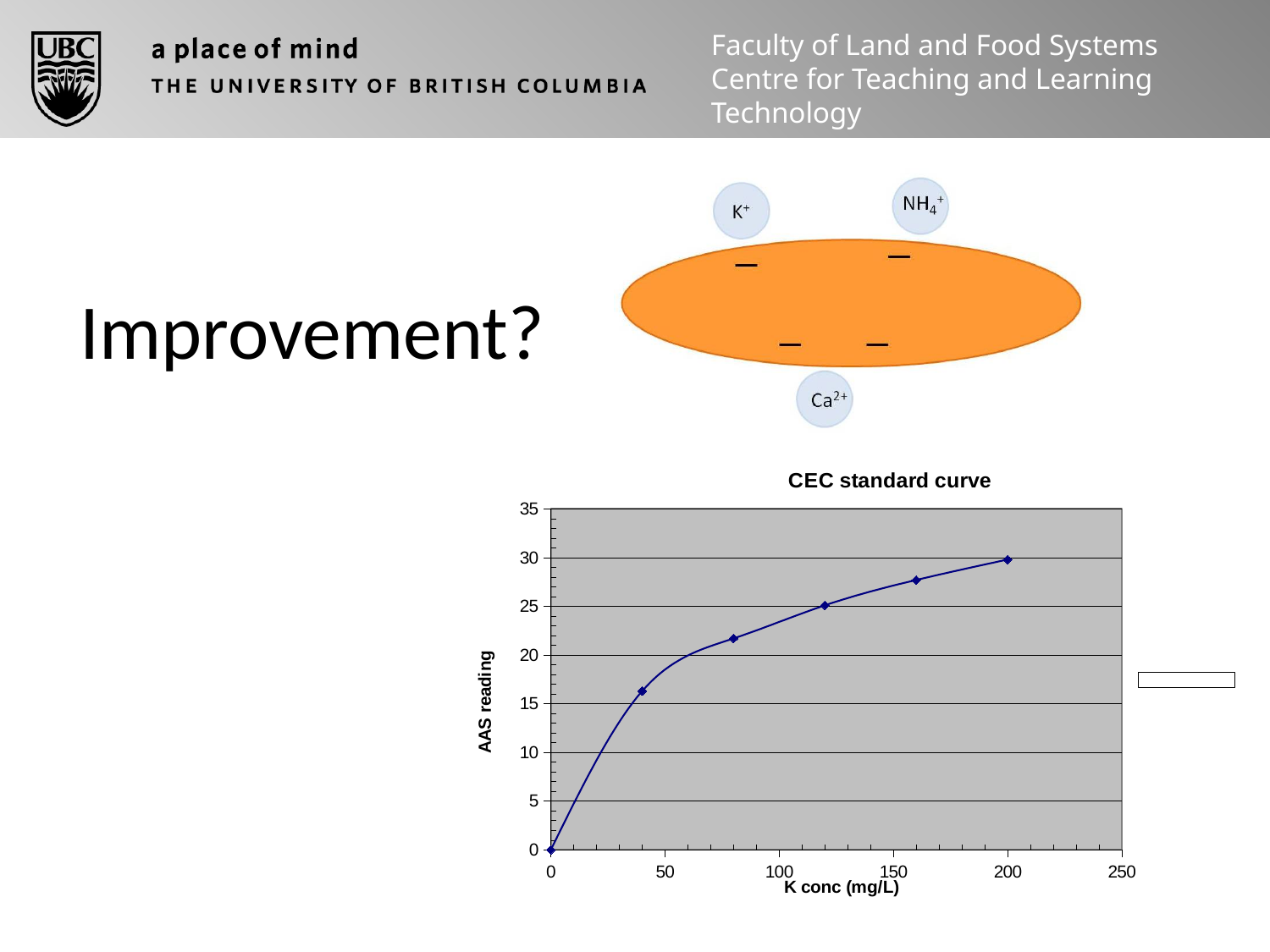
At which K conc (mg/L) is the AAS reading highest? 200 Is the AAS reading at a K conc of 40 mg/L greater or less than 15? greater What is the title of the chart on the slide? CEC standard curve Is the AAS reading at a K conc of 160 mg/L greater or less than 25? greater How many data points are plotted on the CEC standard curve? 6 Do the AAS readings rise or fall as K conc increases along the x axis? rise Which has the larger AAS reading: a K conc of 40 mg/L or 120 mg/L? 120 mg/L What type of chart is the CEC standard curve? line chart Is the AAS reading at a K conc of 80 mg/L greater or less than 20? greater At which K conc (mg/L) is the AAS reading lowest? 0 What is the AAS reading at a K conc of 0 mg/L? 0 What is the label of the x axis of the CEC standard curve chart? K conc (mg/L)